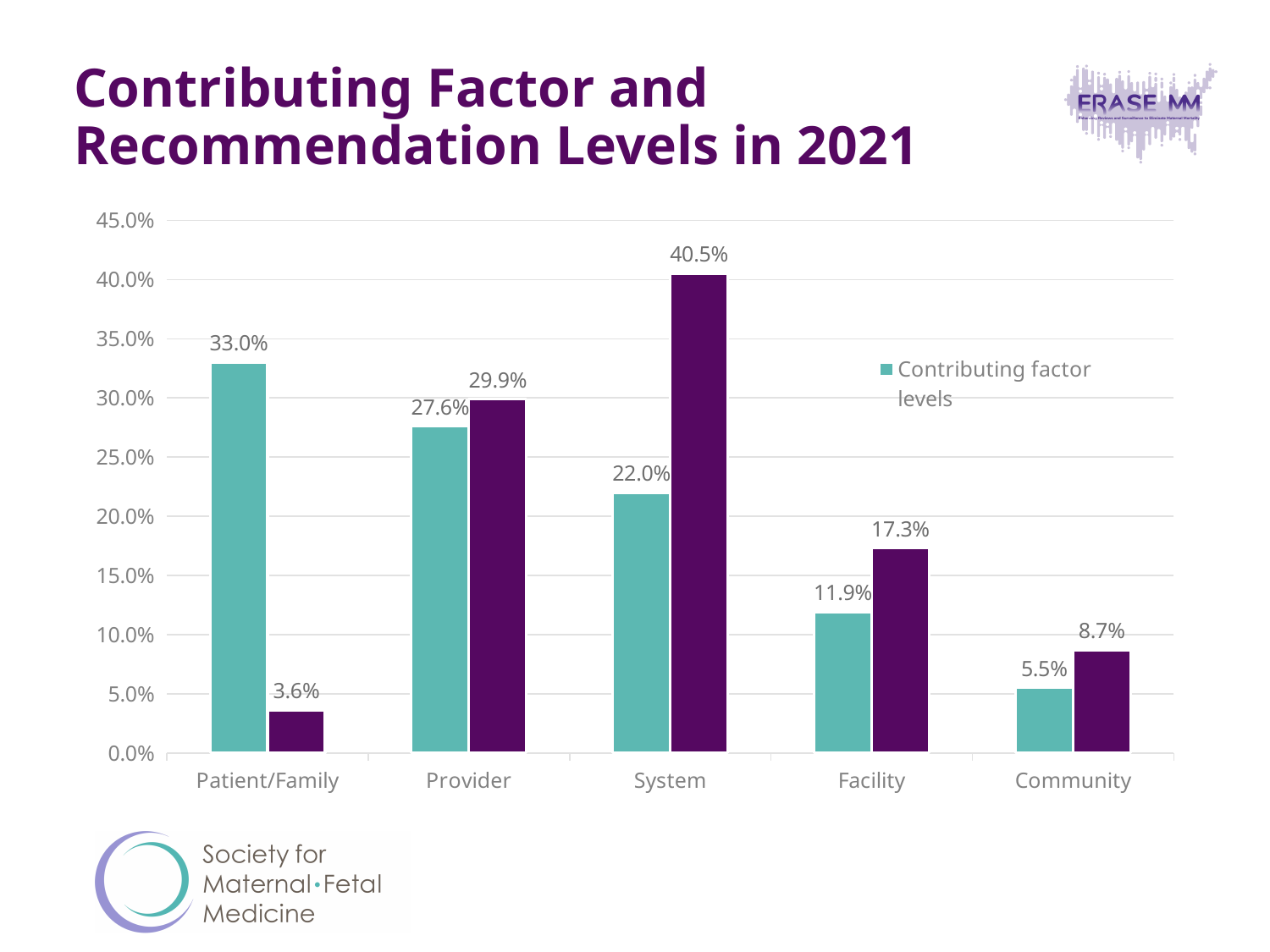
For Provider, is the teal Contributing factor levels bar or the purple bar taller? The purple bar Which category has the shortest purple bar? Patient/Family What is the value of the purple bar for Community? 8.7% Which category has the lowest Contributing factor levels value? Community What is the Contributing factor levels value for Patient/Family? 33.0% What is the value of the purple bar for System? 40.5% Do the Contributing factor levels values rise or fall from Patient/Family to Community? Fall Which category has the highest Contributing factor levels value? Patient/Family Which category has the tallest purple bar? System For System, what is the difference between the purple bar (40.5%) and the Contributing factor levels bar (22.0%)? 18.5 percentage points How many categories are shown on the x axis? 5 What is the Contributing factor levels value for Facility? 11.9%